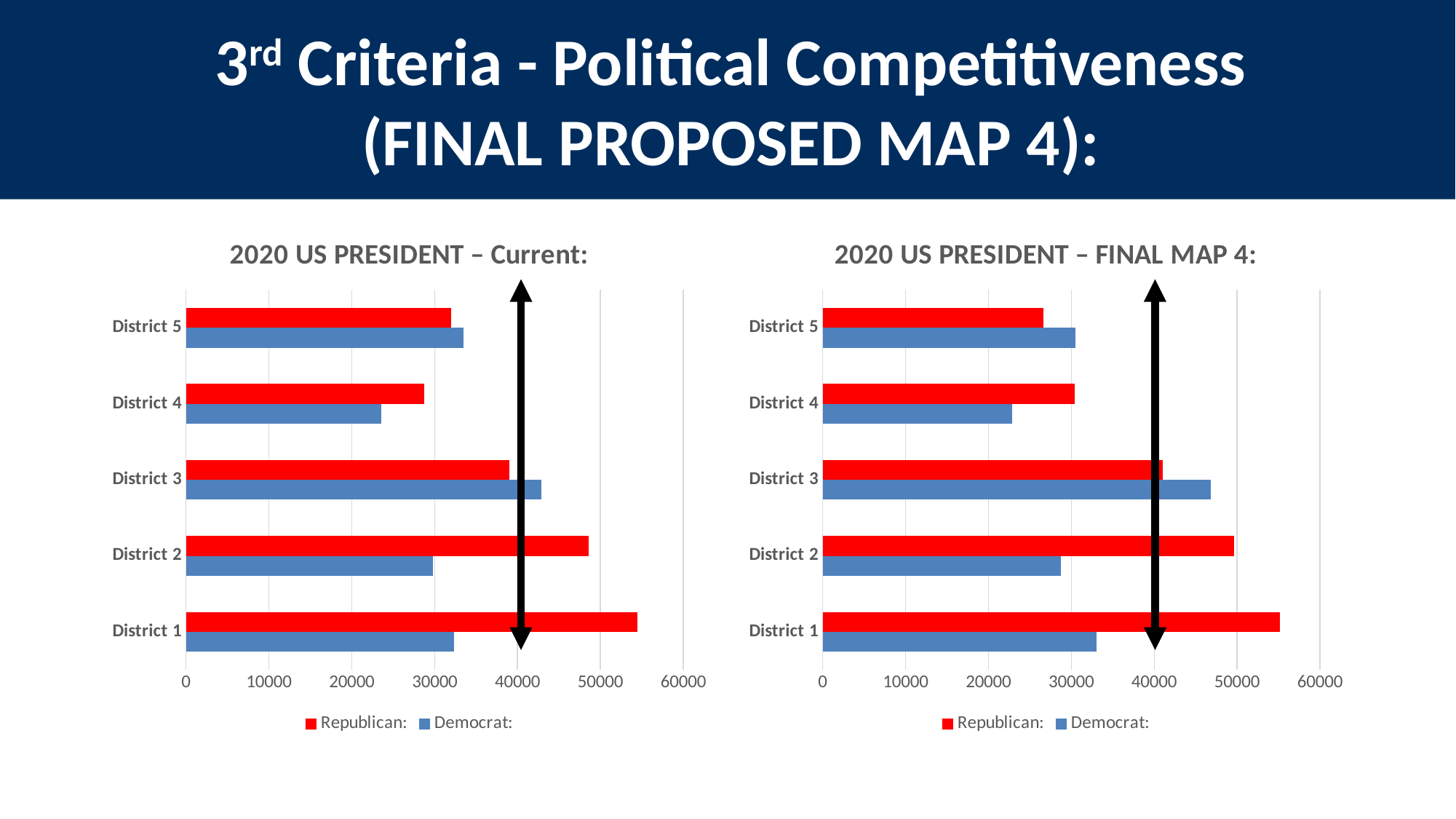
In the "2020 US PRESIDENT – Current:" chart, how many districts are shown? 5 In the "2020 US PRESIDENT – FINAL MAP 4:" chart, is the Democrat value for District 3 greater or less than 40000? greater In the "2020 US PRESIDENT – FINAL MAP 4:" chart, how many series does the legend list? 2 In the "2020 US PRESIDENT – Current:" chart, is the Republican value for District 1 greater or less than 50000? greater In the "2020 US PRESIDENT – Current:" chart, which district has the lowest Democrat value? District 4 In the "2020 US PRESIDENT – FINAL MAP 4:" chart, which is larger for District 3, the Republican or the Democrat value? Democrat In the "2020 US PRESIDENT – Current:" chart, which is larger for District 2, the Republican or the Democrat value? Republican In the "2020 US PRESIDENT – FINAL MAP 4:" chart, is the Democrat value for District 4 greater or less than 30000? less What colour represents the Democrat series in the "2020 US PRESIDENT – Current:" chart? Blue What kind of chart is the "2020 US PRESIDENT – Current:" chart on the left? Bar chart In the "2020 US PRESIDENT – FINAL MAP 4:" chart, which district has the lowest Republican value? District 5 In the "2020 US PRESIDENT – Current:" chart, which district has the highest Republican value? District 1